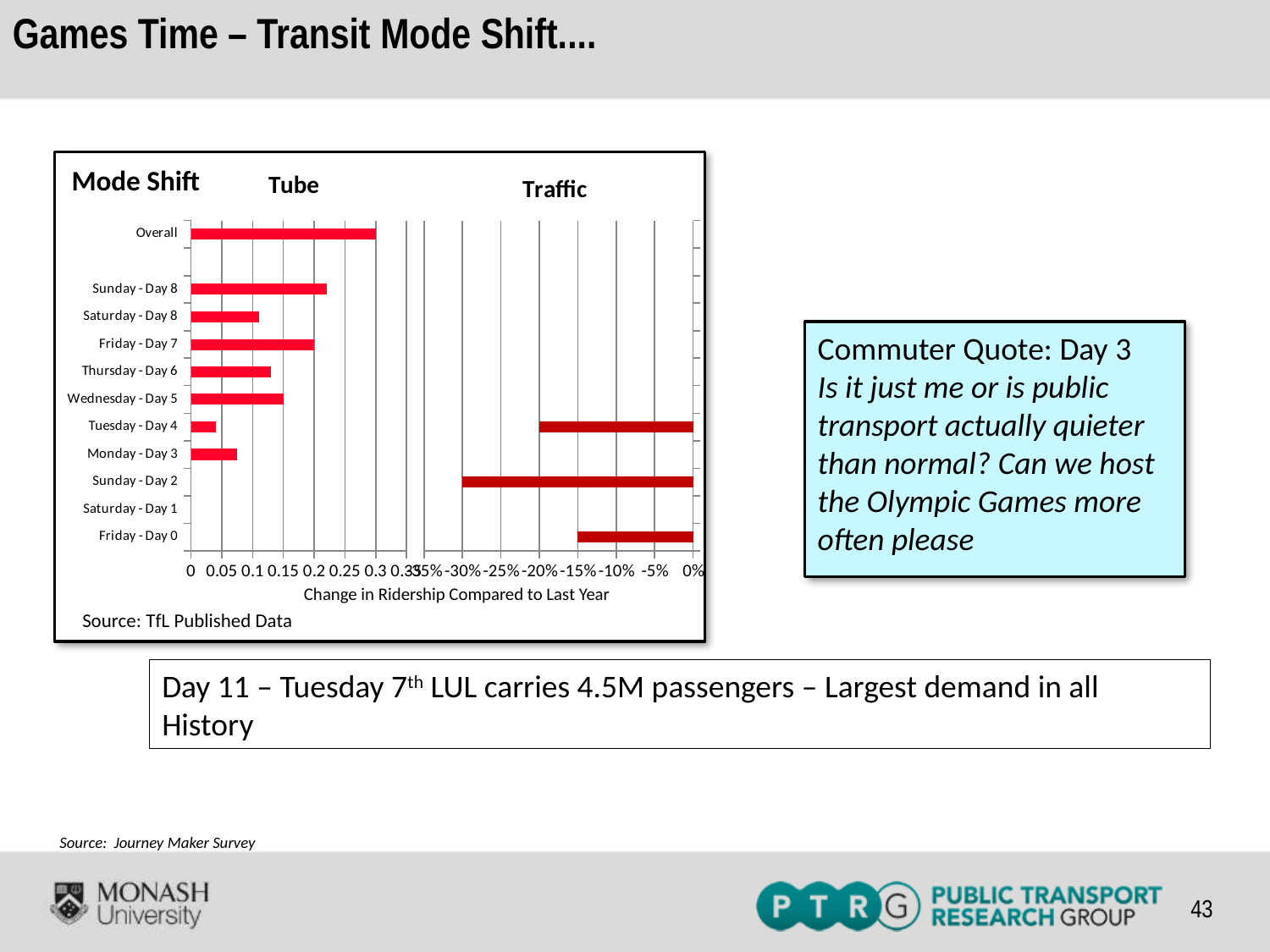
In the Traffic chart, which category shows the largest decrease? Sunday - Day 2 In the Tube chart, what kind of chart is used? bar chart In the Tube chart, which is larger, the value for Friday - Day 7 or Thursday - Day 6? Friday - Day 7 In the Tube chart, which is larger, the value for Wednesday - Day 5 or Monday - Day 3? Wednesday - Day 5 In the Tube chart, is the value for Overall greater or less than 0.25? greater In the Tube chart, is the value for Sunday - Day 8 greater or less than 0.2? greater In the Traffic chart, is the value for Sunday - Day 2 greater or less than -25%? less In the Traffic chart, how many categories have a bar plotted? 3 In the Tube chart, which category has the highest value? Overall In the Tube chart, how many categories are listed on the vertical axis? 11 What is the horizontal axis title shown beneath the Tube and Traffic charts? Change in Ridership Compared to Last Year